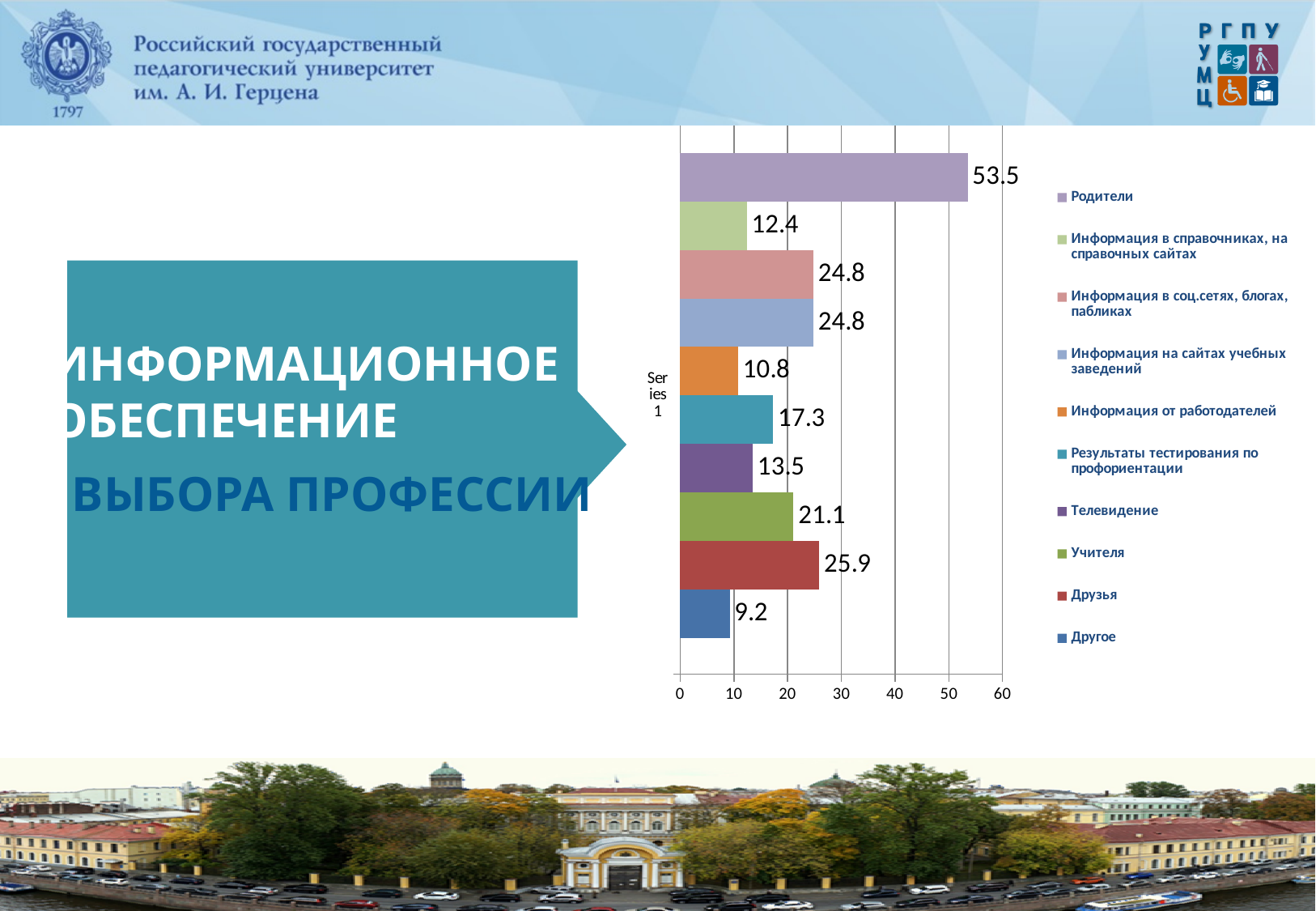
Which is larger, the value for Учителя or the value for Информация от работодателей? Учителя What is the value for Телевидение? 13.5 What is the difference between the values for Родители and Друзья? 27.6 How many bars are plotted in the chart? 10 What kind of chart is shown on the slide? bar chart Which category has the lowest value? Другое What is the highest value shown on the horizontal axis? 60 What is the value for Родители? 53.5 Is the value for Информация в справочниках, на справочных сайтах greater or less than 20? less What is the value for Результаты тестирования по профориентации? 17.3 What is the value for Друзья? 25.9 Which category has the highest value? Родители